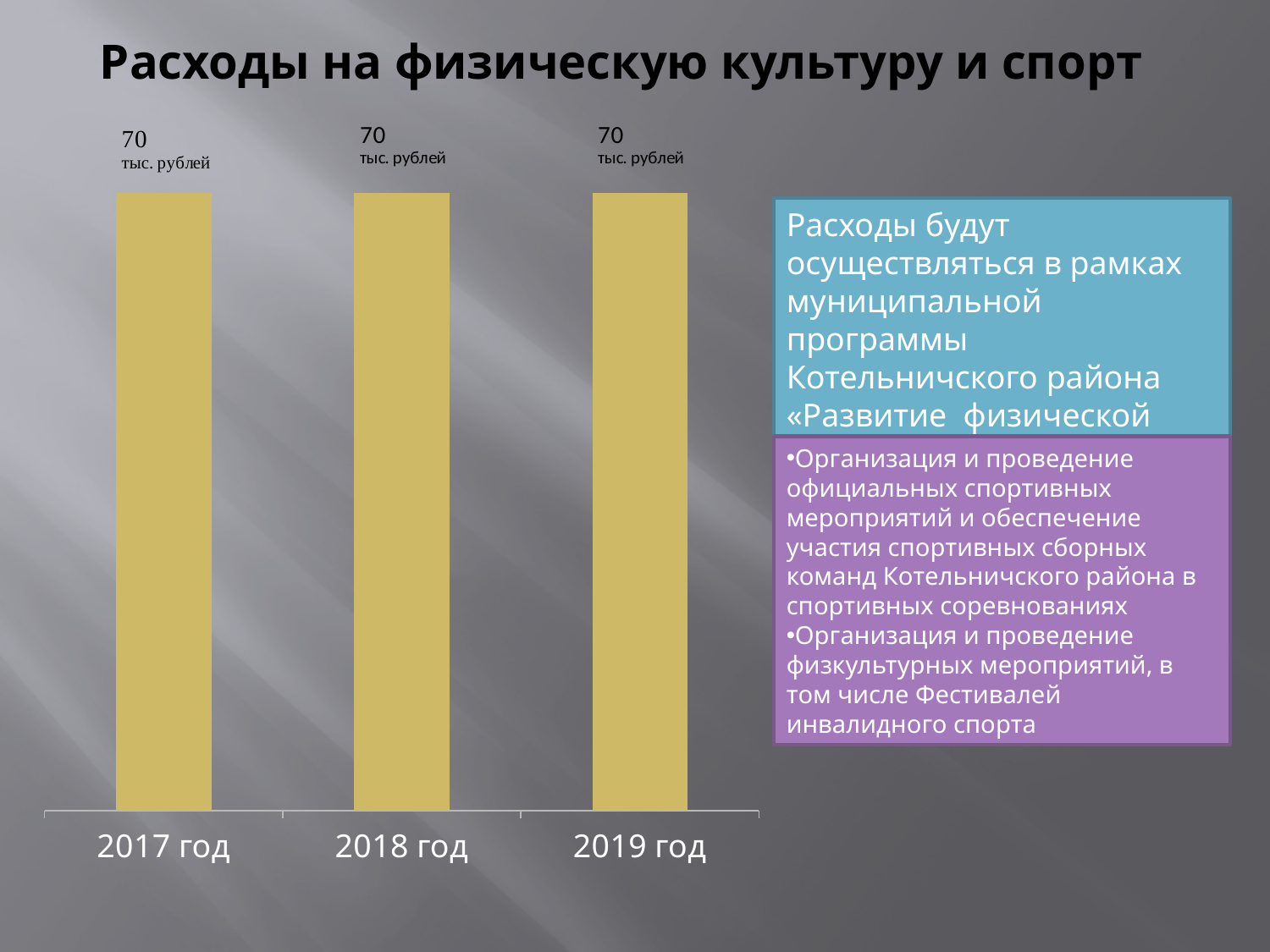
What is the total of the values for 2017 год, 2018 год and 2019 год? 210 тыс. рублей What is the value for 2017 год? 70 тыс. рублей What is the title of the slide containing the chart? Расходы на физическую культуру и спорт What is the difference between the values for 2018 год and 2017 год? 0 What is the value for 2018 год? 70 тыс. рублей What unit are the values on the chart expressed in? тыс. рублей What is the value for 2019 год? 70 тыс. рублей Do the values rise, fall, or stay the same from 2017 год to 2019 год? Stay the same What is the difference between the values for 2019 год and 2017 год? 0 What kind of chart is shown on the slide? Bar chart Which year is the first category on the x axis? 2017 год How many categories (years) are shown on the chart? 3